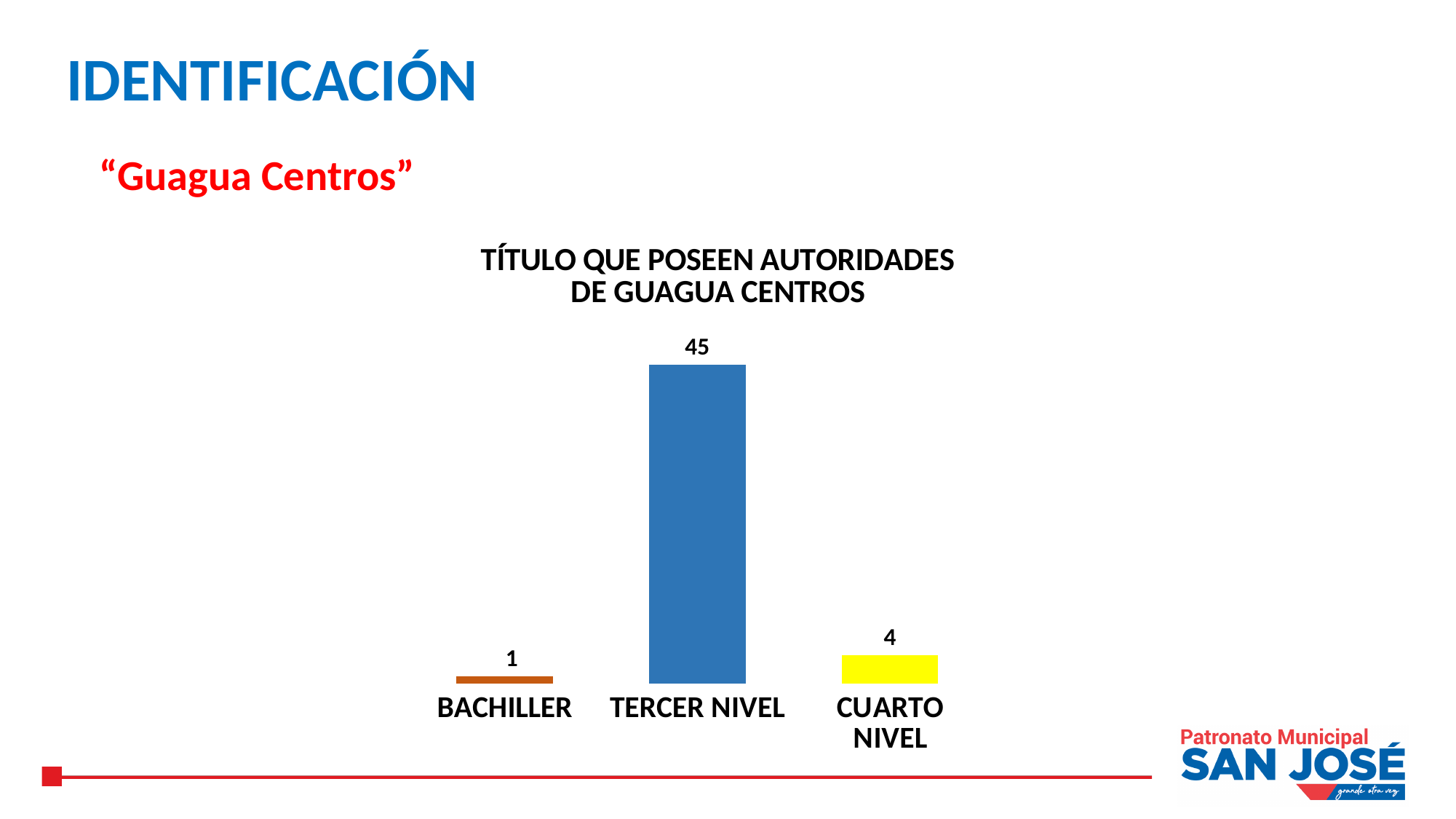
What is the title of the chart? TÍTULO QUE POSEEN AUTORIDADES DE GUAGUA CENTROS Which category has the highest value? TERCER NIVEL What is the value for CUARTO NIVEL? 4 What is the difference between the values for TERCER NIVEL and CUARTO NIVEL? 41 What is the difference between the values for CUARTO NIVEL and BACHILLER? 3 Which category has the lowest value? BACHILLER Which is larger, the value for CUARTO NIVEL or the value for BACHILLER? CUARTO NIVEL What is the value for BACHILLER? 1 What is the value for TERCER NIVEL? 45 What colour is the bar for TERCER NIVEL? blue What kind of chart is shown on the slide? bar chart How many categories are shown in the chart? 3